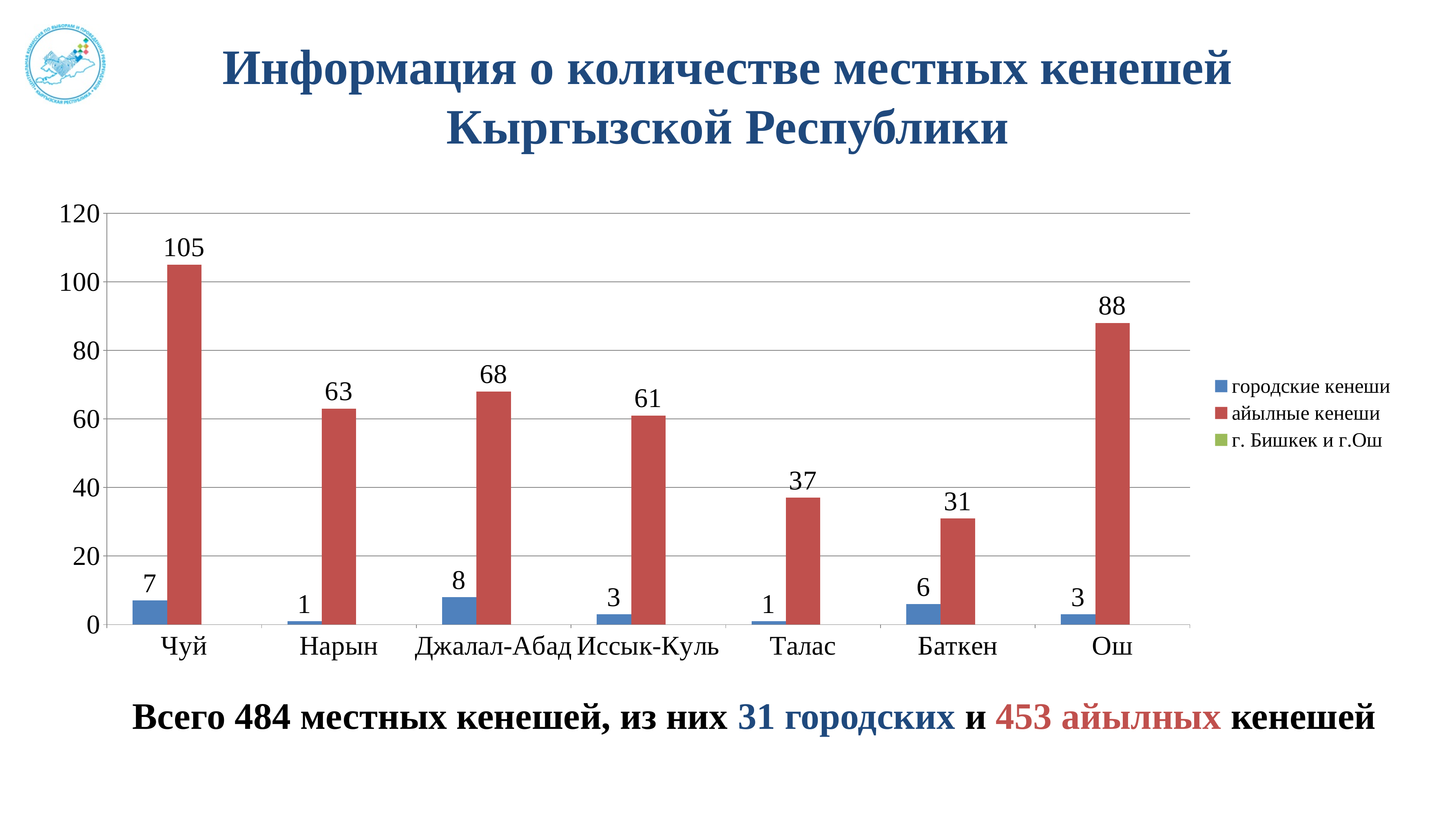
Is the value for айылные кенеши in Талас greater or less than 40? less Which series is shown in red in the legend? айылные кенеши What is the value for городские кенеши in Джалал-Абад? 8 What is the value for айылные кенеши in Чуй? 105 How many series does the legend list? 3 How many regions are shown on the x axis? 7 What is the value for айылные кенеши in Ош? 88 What kind of chart is shown on the slide? bar chart Which region has the highest value for айылные кенеши? Чуй Which region has the lowest value for айылные кенеши? Баткен What is the difference between the айылные кенеши values for Чуй and Ош? 17 Which is larger: the айылные кенеши value for Нарын or for Иссык-Куль? Нарын